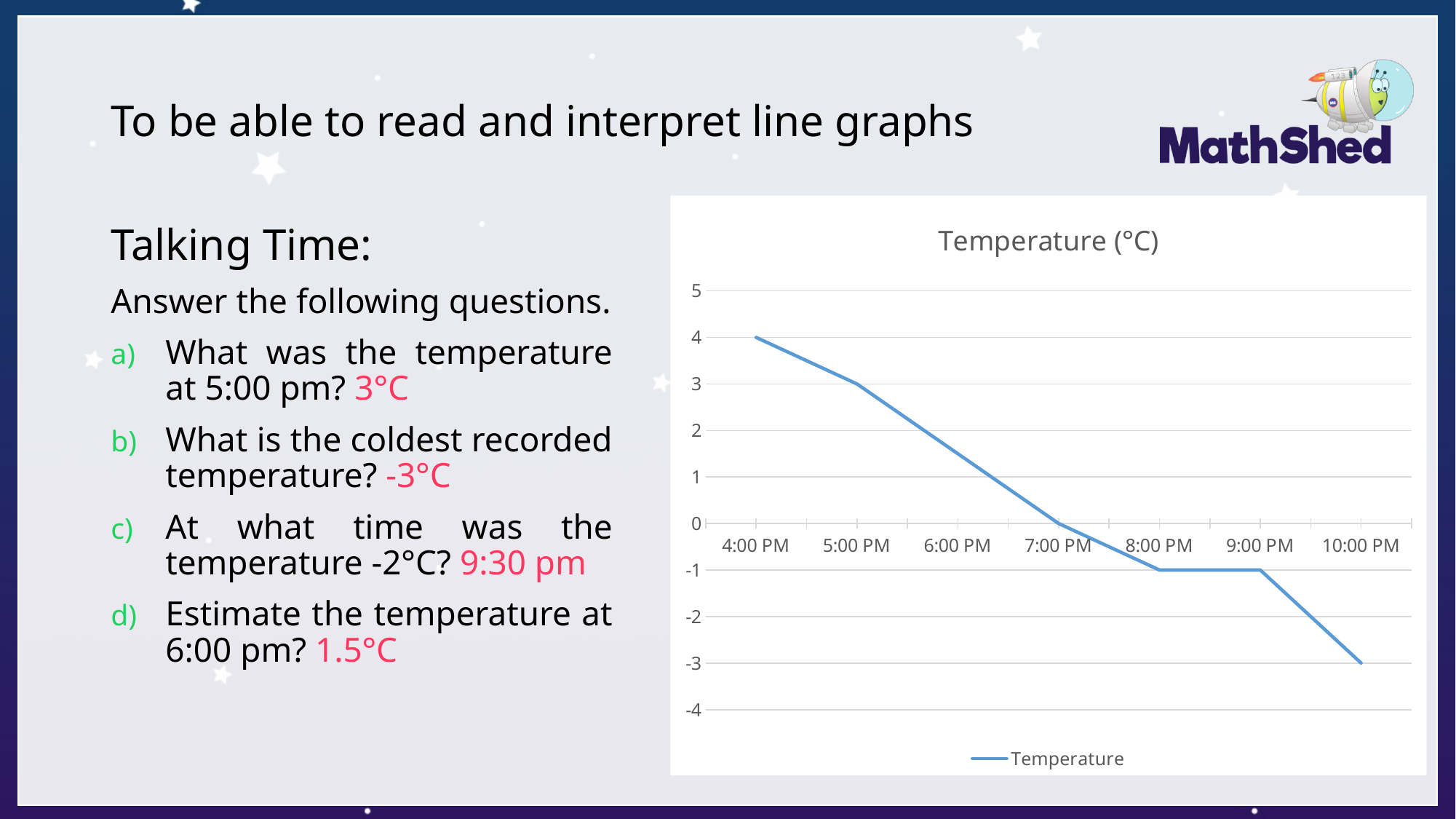
Is the temperature at 6:00 PM greater or less than 1? greater What is the title of the chart? Temperature (°C) At which time was the temperature lowest? 10:00 PM What was the temperature at 5:00 PM? 3 What kind of chart is shown on the slide? line chart Does the temperature rise or fall from 4:00 PM to 10:00 PM? fall What was the temperature at 8:00 PM? -1 How many time points are plotted on the x axis of the chart? 7 At which time was the temperature highest? 4:00 PM What was the temperature at 10:00 PM? -3 What was the temperature at 4:00 PM? 4 How many series does the chart legend list? 1